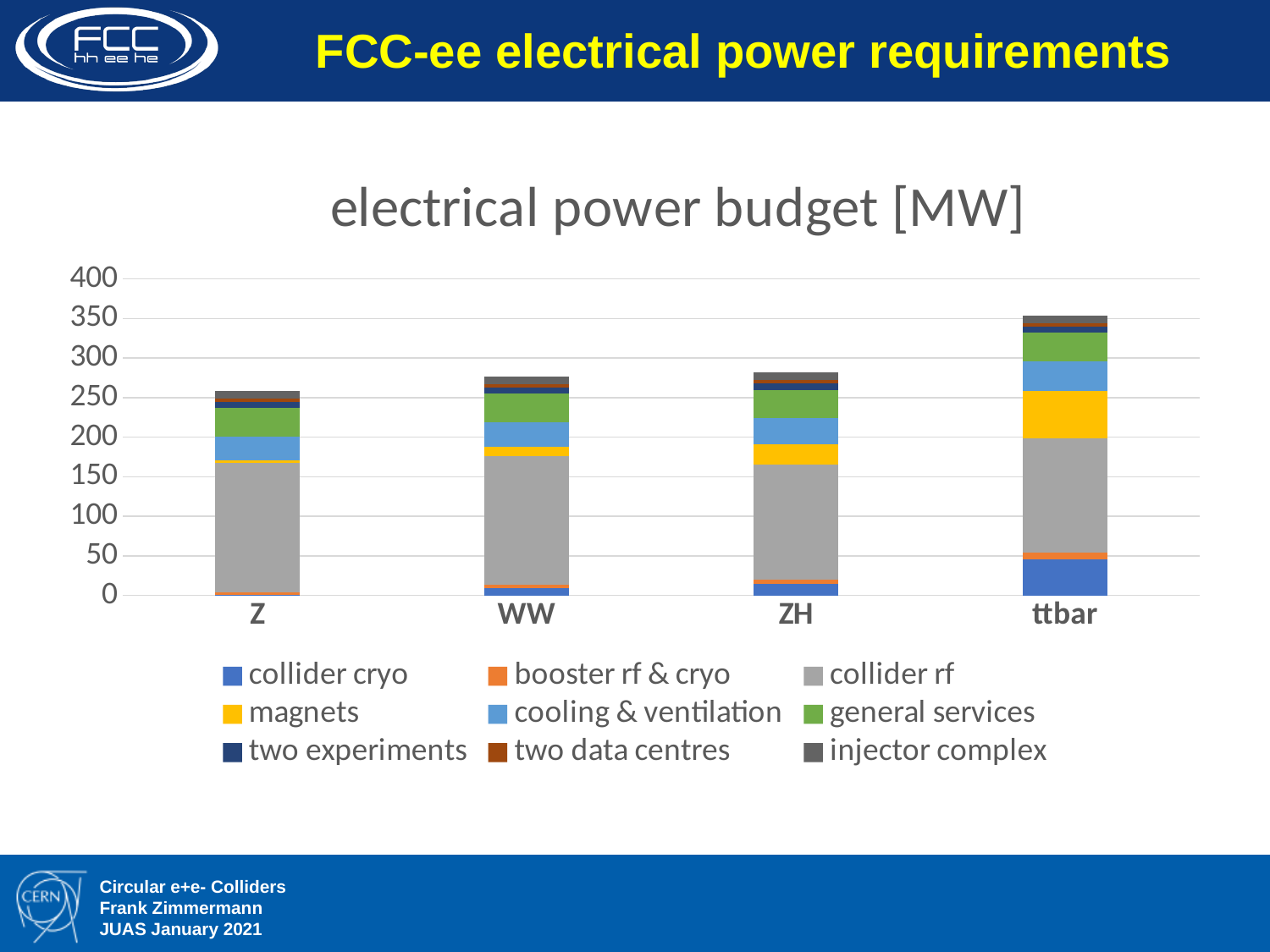
How many categories are shown on the x axis of the chart? 4 Which category has the highest total electrical power budget? ttbar Is the total for Z greater or less than 300? less Which has the larger total electrical power budget, ttbar or Z? ttbar What is the title of the chart? electrical power budget [MW] Is the total for WW greater or less than 250? greater How many series does the legend list? 9 Is the total for ttbar greater or less than 300? greater What kind of chart is shown on the slide? stacked bar chart Which series makes up the largest part of each bar? collider rf Which category has the lowest total electrical power budget? Z Do the total bar heights rise or fall from Z to ttbar along the x axis? rise